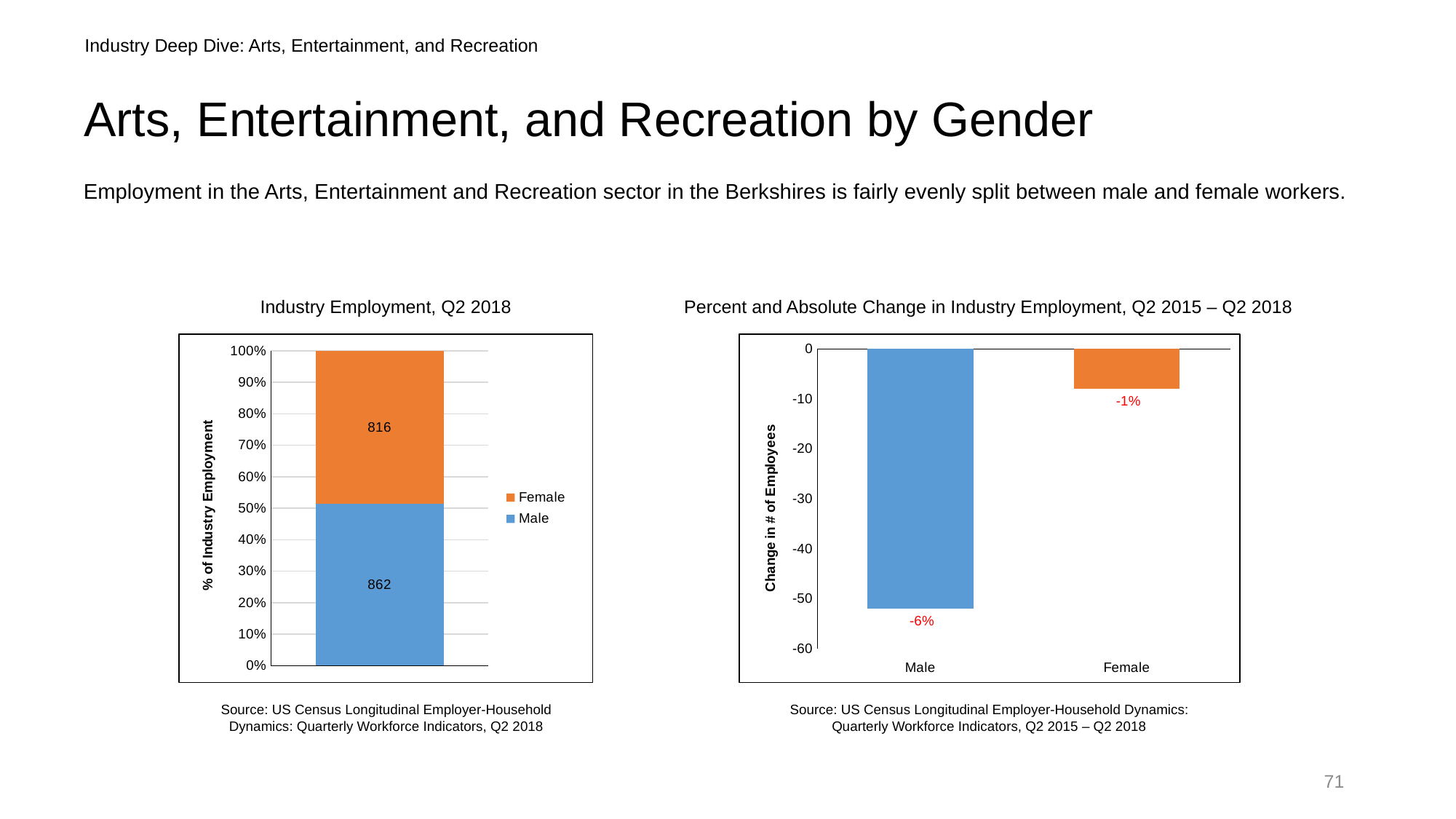
In the 'Percent and Absolute Change in Industry Employment, Q2 2015 – Q2 2018' chart, what percent change is labelled for Male? -6% In the 'Industry Employment, Q2 2018' chart, what is the value labelled on the Male segment? 862 In the 'Industry Employment, Q2 2018' chart, what is the total of the two stacked segments? 1678 In the 'Industry Employment, Q2 2018' chart, which colour represents Female? Orange What kind of chart is the 'Percent and Absolute Change in Industry Employment, Q2 2015 – Q2 2018' chart? Bar chart In the 'Percent and Absolute Change in Industry Employment, Q2 2015 – Q2 2018' chart, which gender shows the larger decline in number of employees? Male In the 'Industry Employment, Q2 2018' chart, which gender has the larger labelled value? Male In the 'Industry Employment, Q2 2018' chart, how many series does the legend list? 2 In the 'Industry Employment, Q2 2018' chart, what is the difference between the Male and Female labelled values? 46 In the 'Industry Employment, Q2 2018' chart, what is the value labelled on the Female segment? 816 In the 'Percent and Absolute Change in Industry Employment, Q2 2015 – Q2 2018' chart, what percent change is labelled for Female? -1% In the 'Percent and Absolute Change in Industry Employment, Q2 2015 – Q2 2018' chart, is the change in number of employees for Male greater or less than -40? less